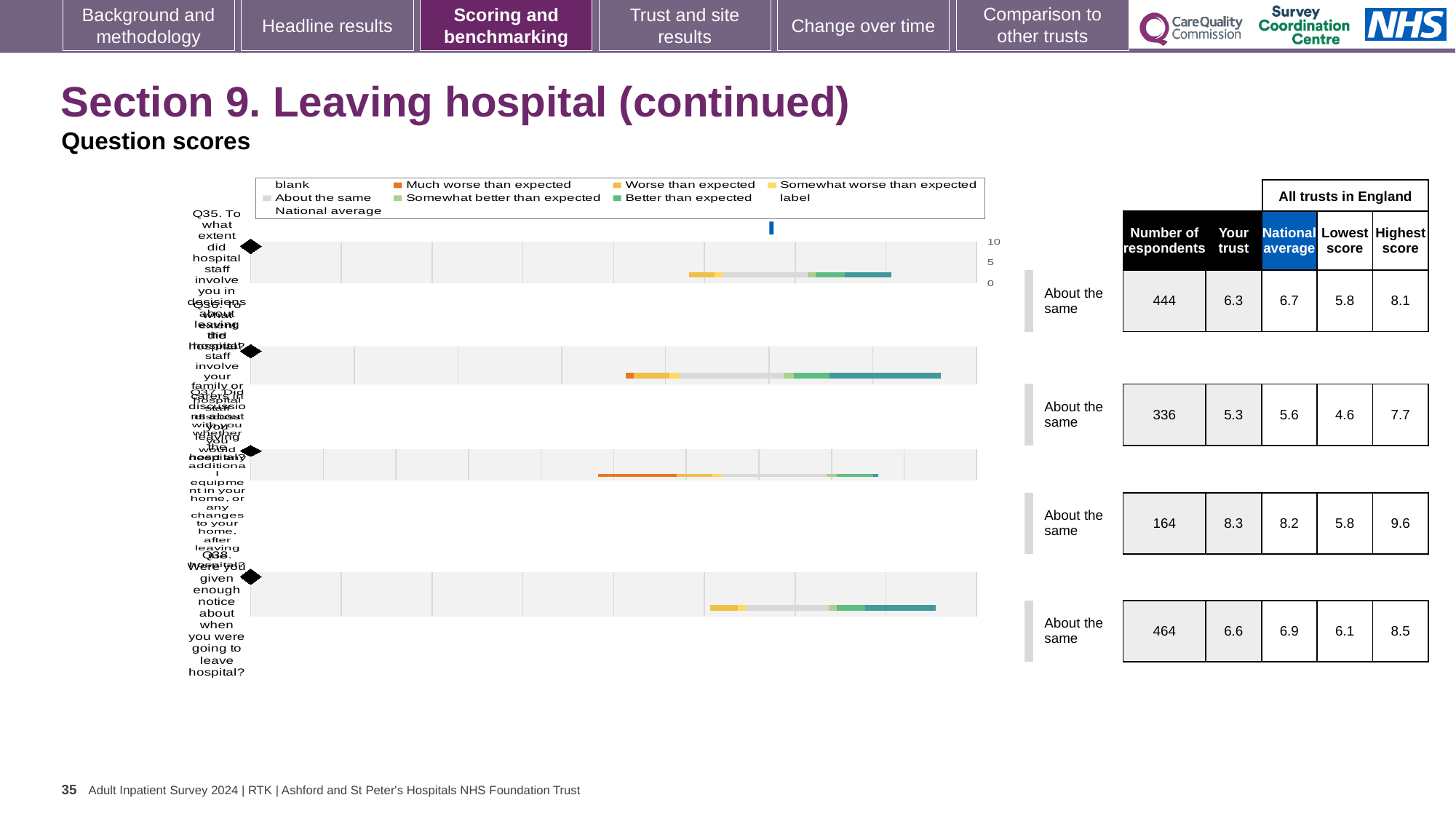
Which question has the lowest 'Your trust' score in the table beside the chart? Q36 According to the table beside the chart, what is the 'Your trust' score for Q35? 6.3 According to the table beside the chart, what is the national average for Q36? 5.6 For Q37, which is larger: the 'Your trust' score or the national average? Your trust What benchmark category is shown for Q38? About the same How many questions (rows) are plotted in the chart? 4 What kind of chart is used to show the question scores on this slide? Bar chart Which question has the highest 'Your trust' score in the table beside the chart? Q37 What is the difference between the national average and the 'Your trust' score for Q35? 0.4 What is the highest score among all trusts in England for Q37? 9.6 According to the table beside the chart, how many respondents answered Q37? 164 What is the subtitle shown above the chart? Question scores